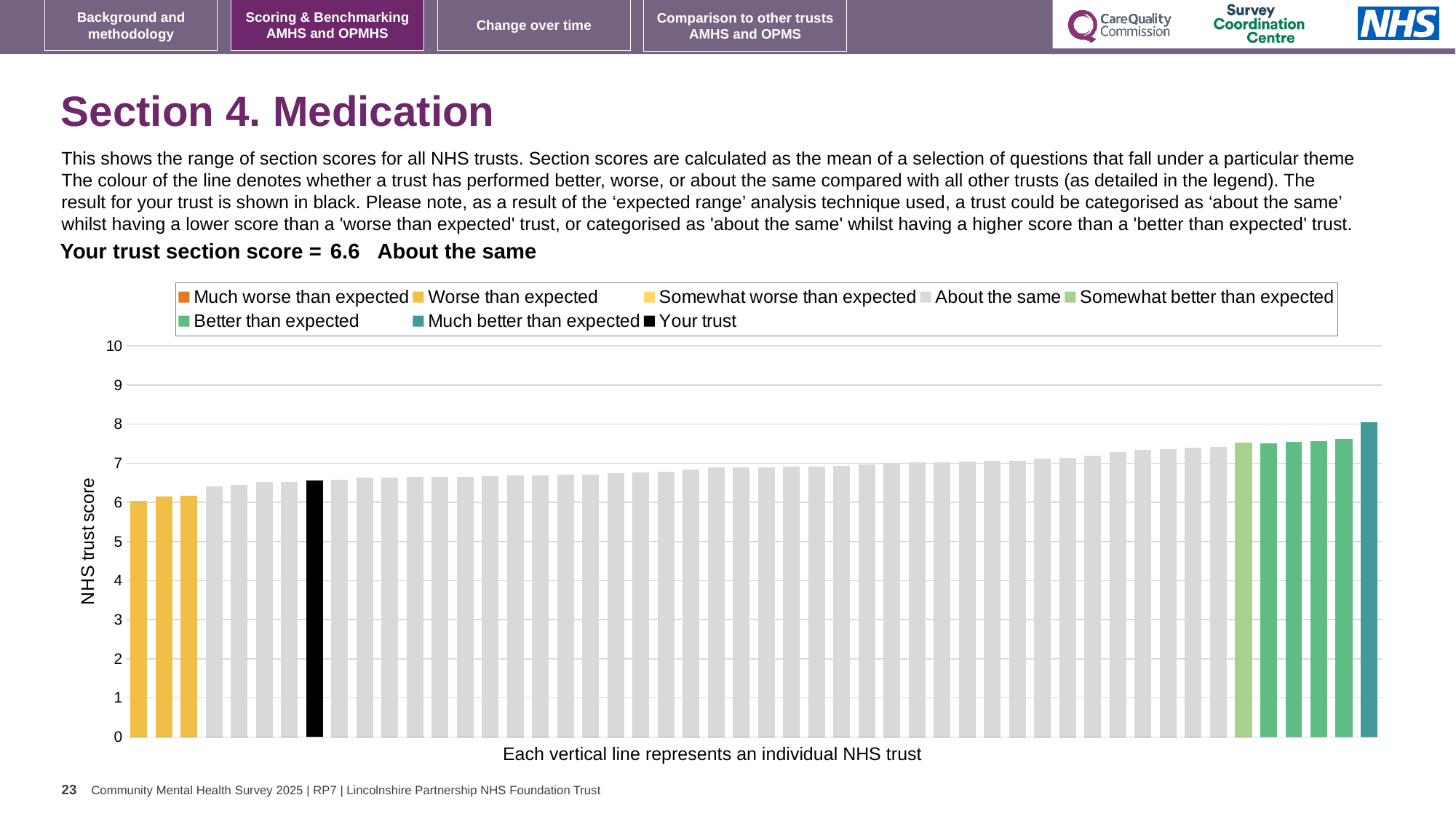
What kind of chart is shown on the slide? bar chart How many entries does the chart legend list? 8 Is the lowest bar in the chart greater or less than 5? greater Is the value for your trust greater or less than 7? less How many bars are coloured as 'Worse than expected'? 3 Is the tallest bar in the chart greater or less than 7? greater What is the label on the vertical axis of the chart? NHS trust score What colour is the bar representing your trust? black How many bars are coloured as 'Much better than expected'? 1 Do the bar values rise or fall from left to right along the x axis? rise Which category is your trust placed in for this section? About the same What is the section score for your trust shown on the slide? 6.6